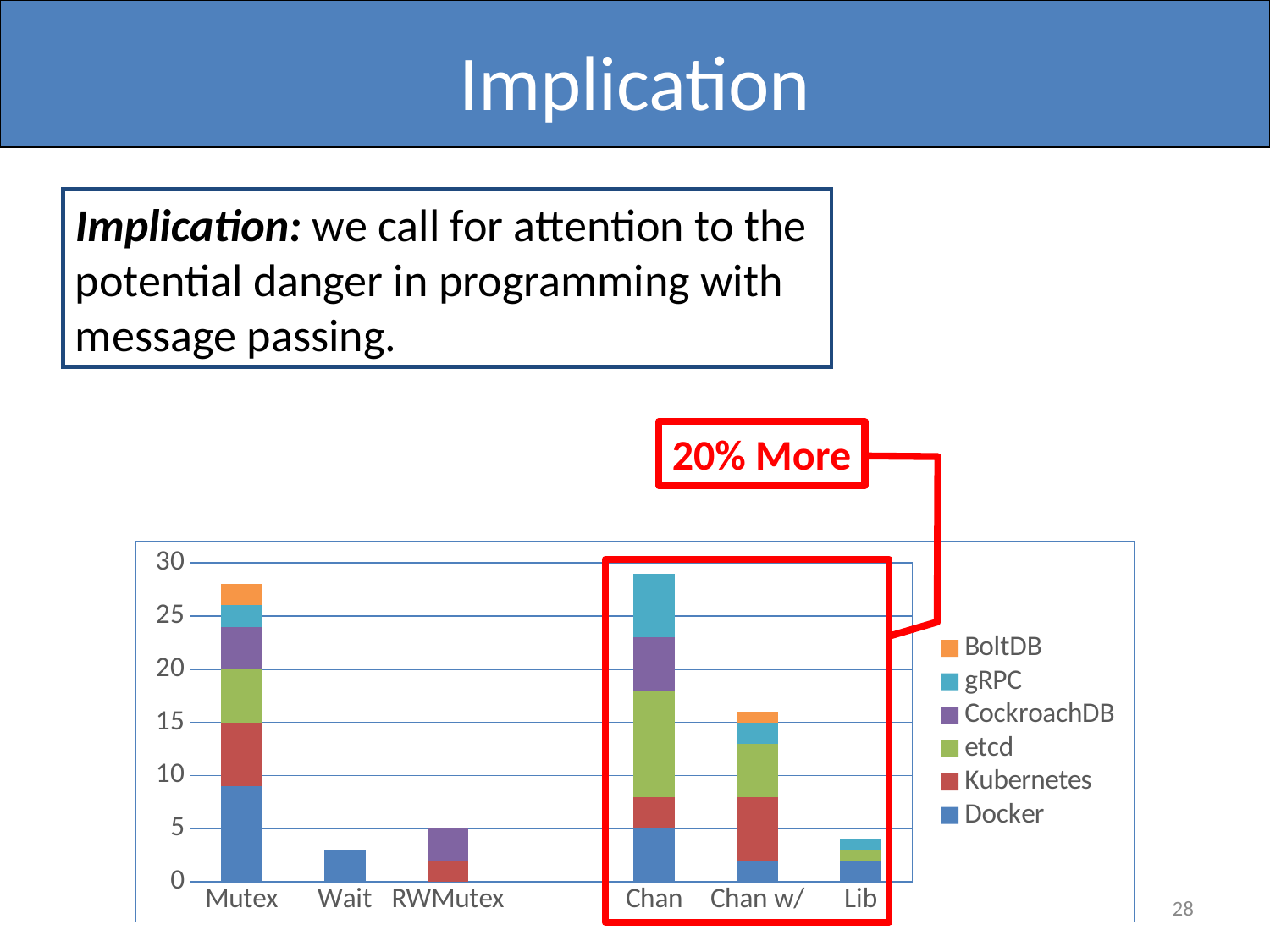
Is the total value of the Lib bar greater or less than 5? less Is the total value of the Chan bar greater or less than 25? greater Is the total value of the Wait bar greater or less than 5? less How many series does the chart's legend list? 6 What kind of chart is shown on the slide? stacked bar chart What text is shown in the red callout box above the chart? 20% More How many categories are shown on the x axis of the chart? 6 Which bar is taller, Mutex or Chan w/? Mutex Which bar is taller, Wait or Chan w/? Chan w/ Which series is listed last (at the bottom) in the chart's legend? Docker